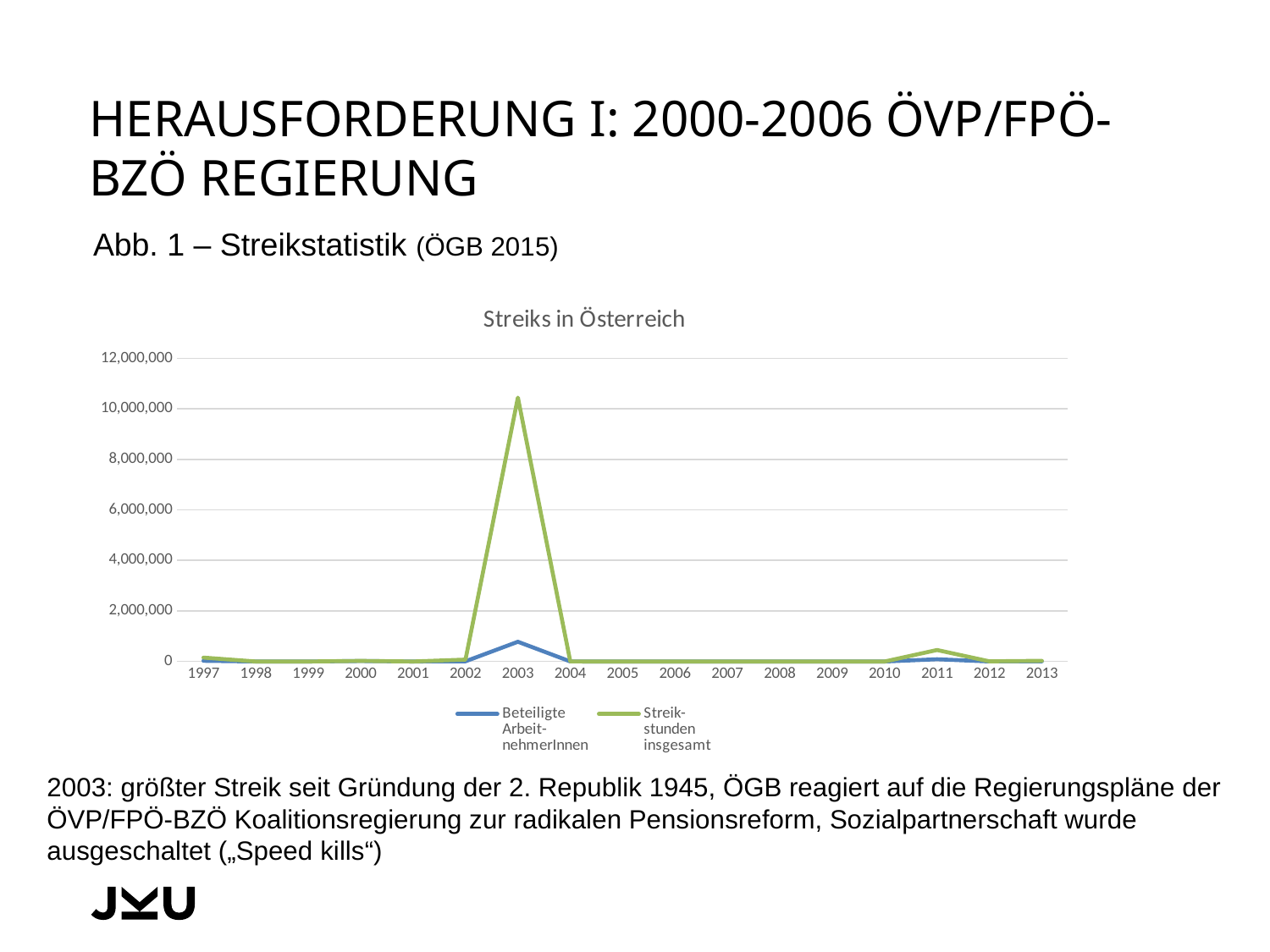
Which colour represents the series 'Streikstunden insgesamt' in the chart? green What kind of chart is shown on the slide? line chart Which year has the larger value for 'Streikstunden insgesamt', 2003 or 2011? 2003 Is the value for 'Streikstunden insgesamt' in 2003 greater or less than 8,000,000? greater Is the value for 'Streikstunden insgesamt' in 2011 greater or less than 2,000,000? less How many series does the chart's legend list? 2 In which year does the series 'Streikstunden insgesamt' reach its highest value? 2003 In which year does the series 'Beteiligte ArbeitnehmerInnen' reach its highest value? 2003 How many years are plotted along the x axis of the chart? 17 What is the title of the chart? Streiks in Österreich Does the series 'Streikstunden insgesamt' rise or fall from 2003 to 2004? fall Is the value for 'Beteiligte ArbeitnehmerInnen' in 2003 greater or less than 2,000,000? less